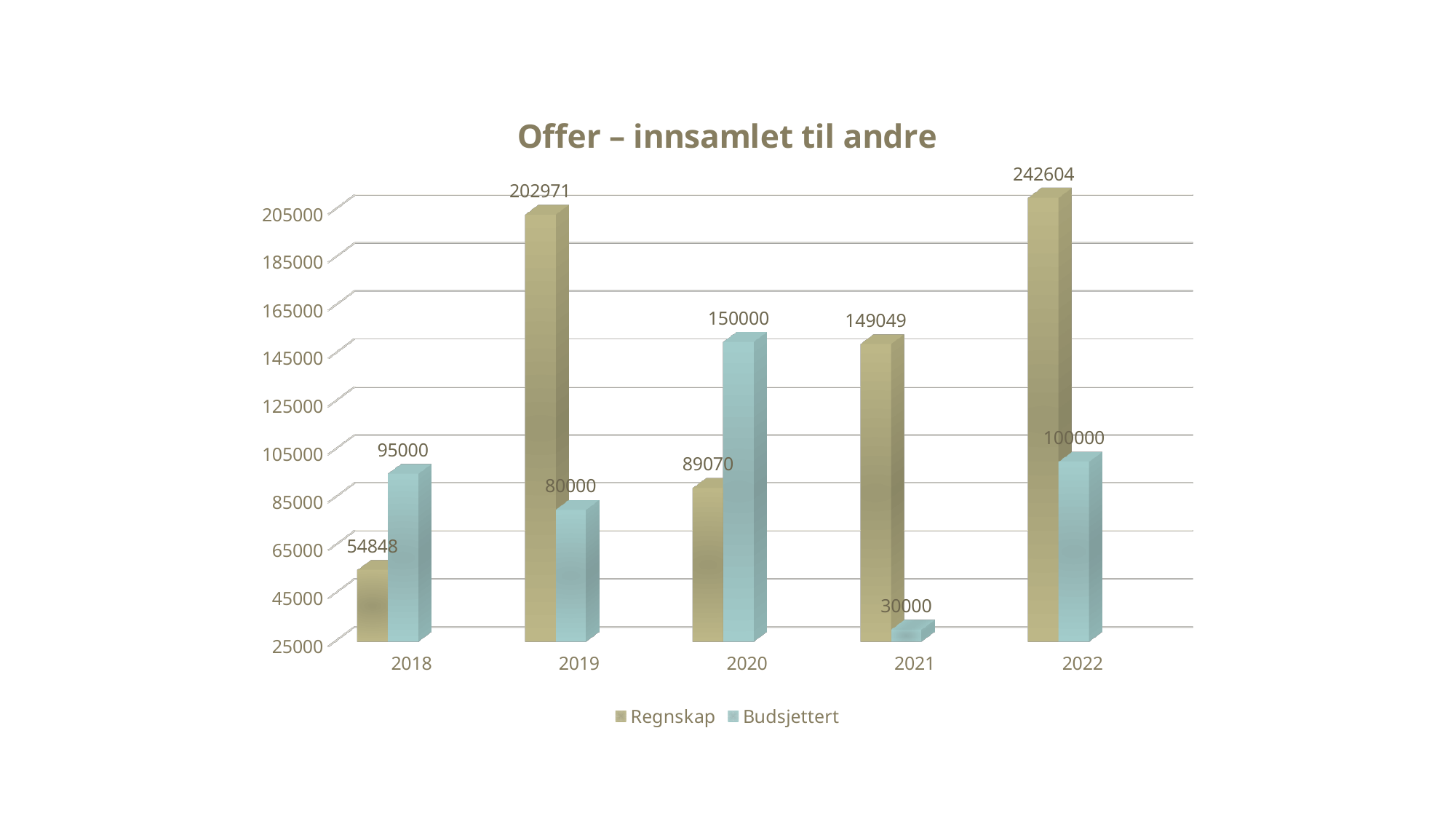
Is the Regnskap value for 2021 greater or less than 145000? greater What is the Regnskap value for 2019? 202971 Which year has the highest Regnskap value? 2022 How many series does the legend list? 2 Which year has the lowest Budsjettert value? 2021 What is the Budsjettert value for 2020? 150000 What is the title of the chart? Offer – innsamlet til andre How many years are shown on the x axis? 5 What is the difference between the Regnskap and Budsjettert values for 2022? 142604 Which is larger for 2020, Regnskap or Budsjettert? Budsjettert What kind of chart is shown? bar chart What is the Regnskap value for 2018? 54848